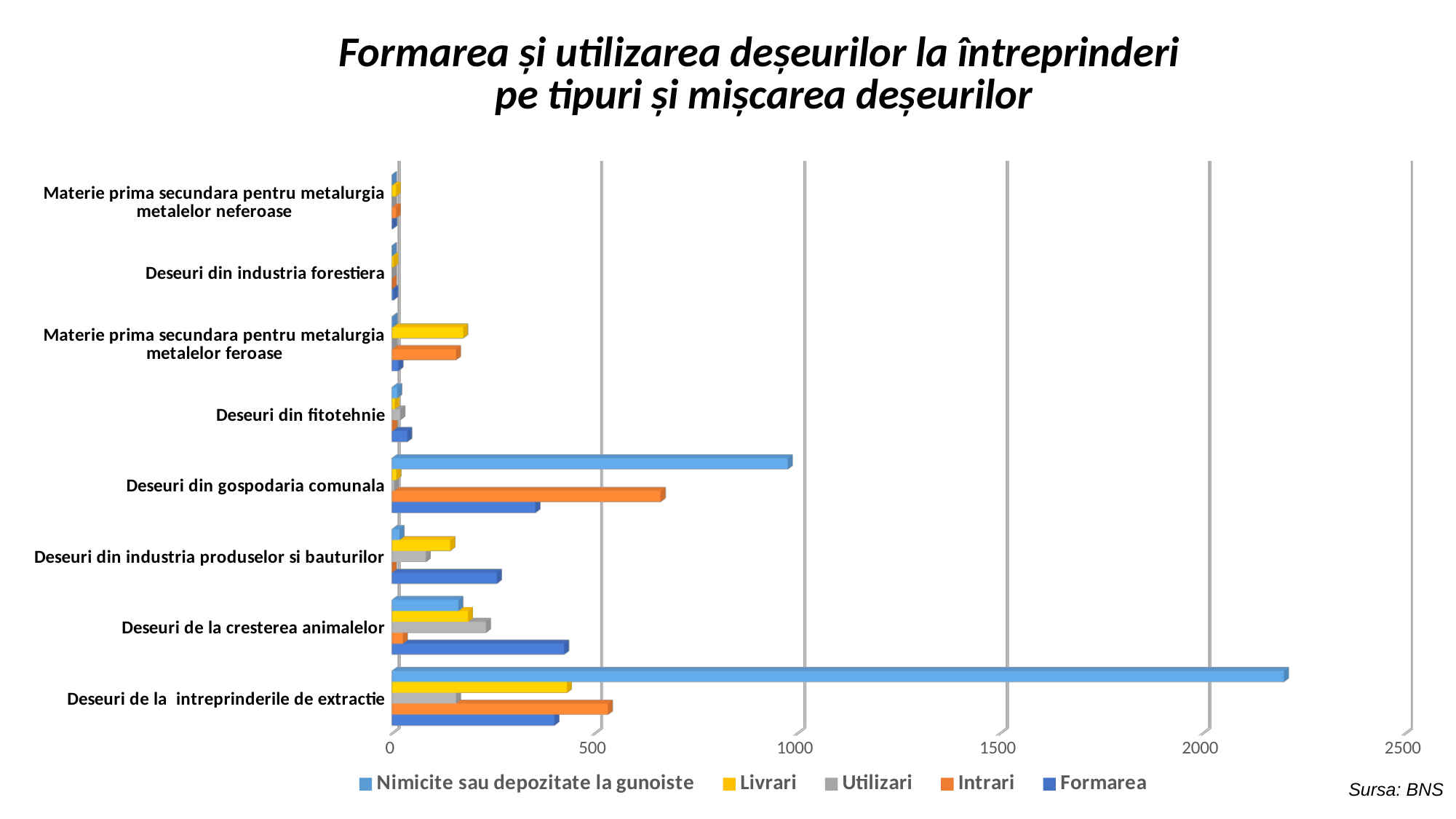
How many waste categories are listed on the vertical axis of the chart? 8 Is the value of 'Nimicite sau depozitate la gunoiste' for 'Deseuri de la intreprinderile de extractie' greater or less than 2000? greater What kind of chart is shown on the slide? bar chart Which is larger: the 'Formarea' value for 'Deseuri de la cresterea animalelor' or for 'Deseuri din industria produselor si bauturilor'? Deseuri de la cresterea animalelor Is the value of 'Nimicite sau depozitate la gunoiste' for 'Deseuri din gospodaria comunala' greater or less than 500? greater Is the value of 'Formarea' for 'Deseuri din gospodaria comunala' greater or less than 500? less Which category has the longest bar in the chart? Deseuri de la intreprinderile de extractie Which is larger: the 'Intrari' value for 'Deseuri din gospodaria comunala' or for 'Deseuri de la intreprinderile de extractie'? Deseuri din gospodaria comunala Which series has the smallest value for 'Deseuri de la cresterea animalelor'? Intrari What source is cited for the chart's data? BNS How many series does the chart's legend list? 5